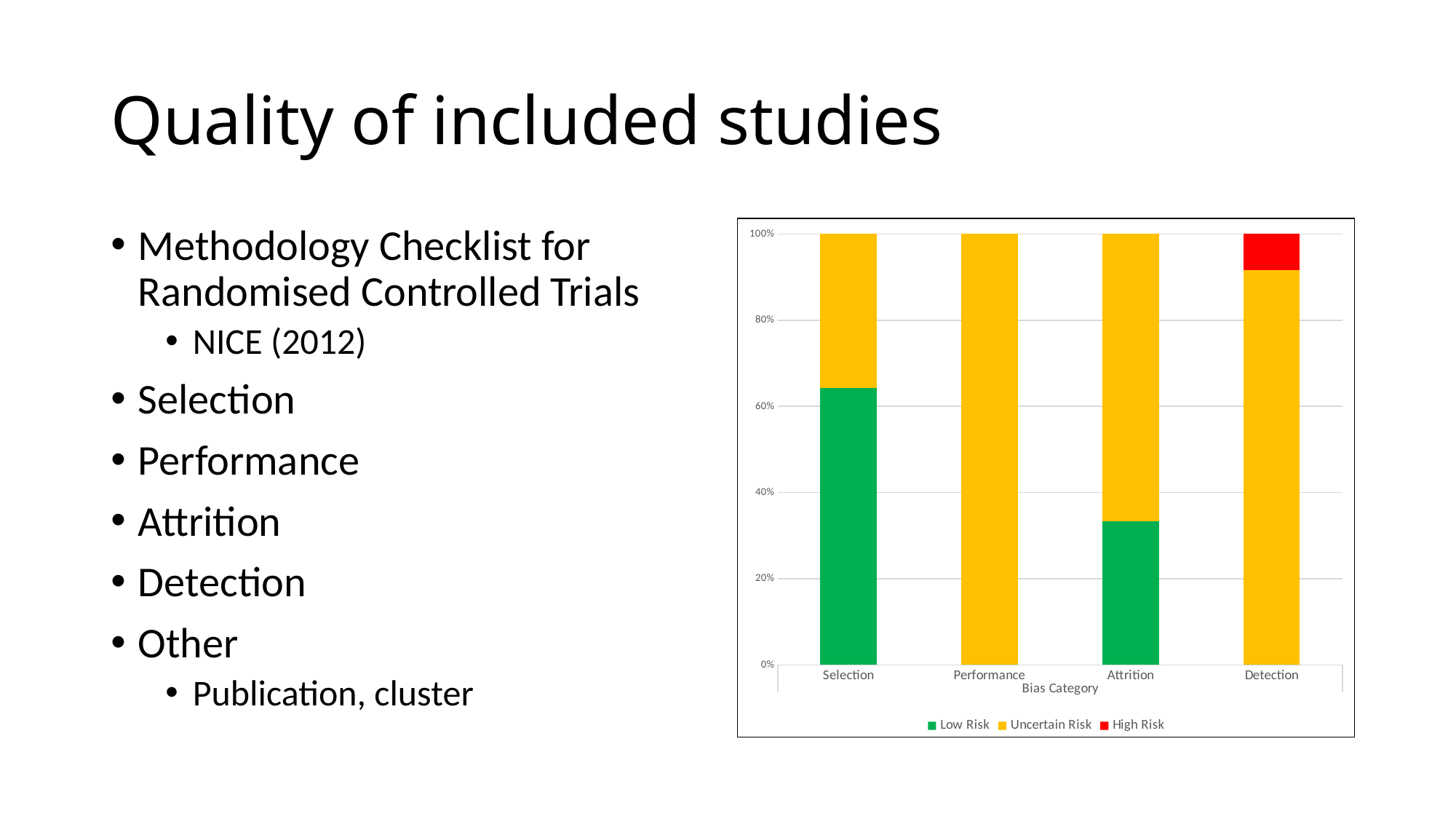
Is the Uncertain Risk share for Detection greater or less than 80%? greater What is the title of the x axis of the chart? Bias Category Which bias category has the largest Low Risk share? Selection Is the Low Risk share for Attrition greater or less than 40%? less Is the High Risk share for Detection greater or less than 20%? less How many bias categories are shown on the x axis of the chart? 4 Which has a larger Low Risk share, Selection or Attrition? Selection How many series does the chart legend list? 3 What kind of chart is shown on the slide? Stacked bar chart What is the Uncertain Risk share for the Performance bias category? 100% Which bias category is the only one with a High Risk segment? Detection